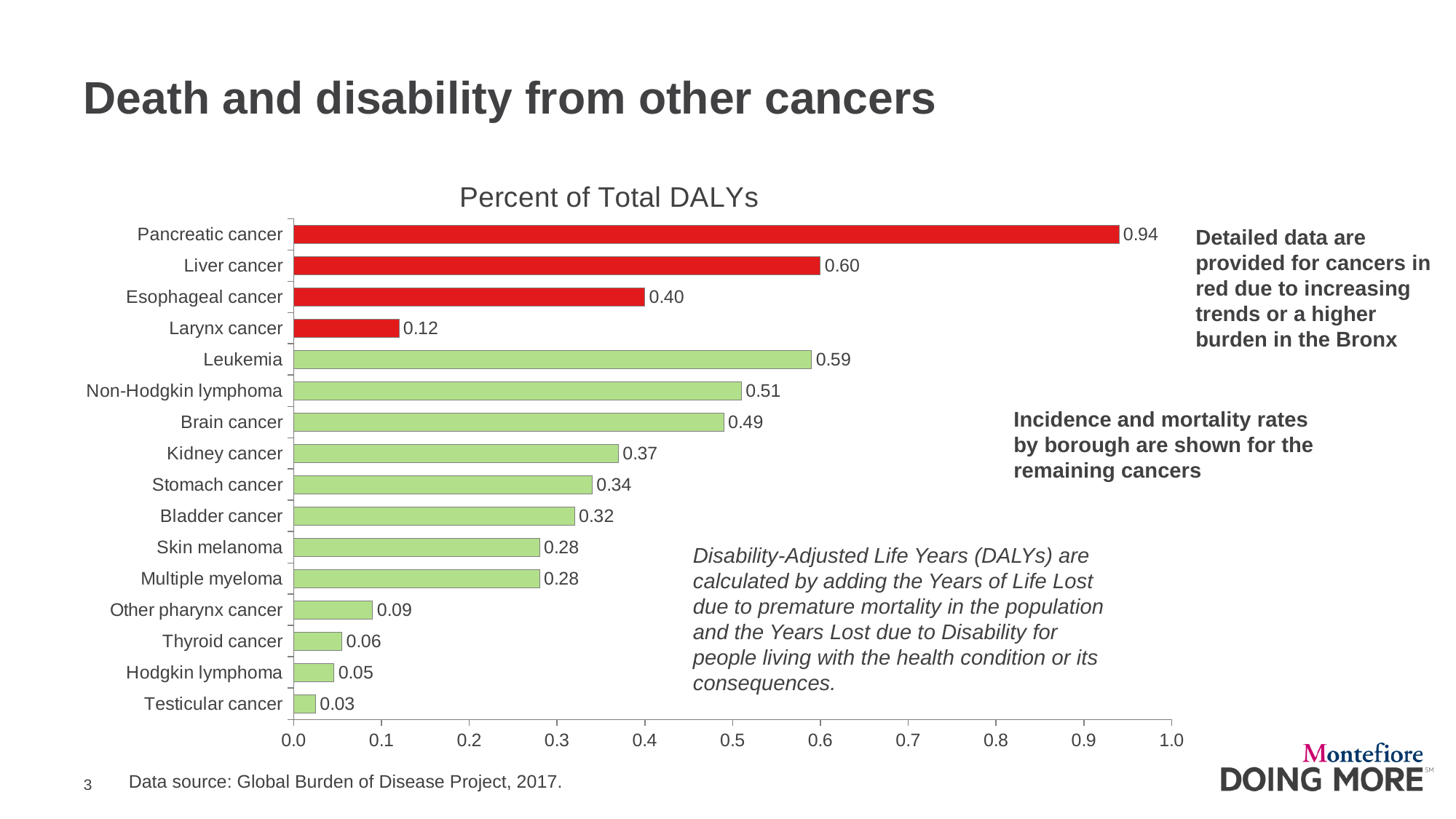
How many bars are coloured red? 4 Which is larger, the value for Esophageal cancer or the value for Brain cancer? Brain cancer How many categories are shown in the chart? 16 What is the difference between the values for Stomach cancer and Bladder cancer? 0.02 Which category has the lowest value? Testicular cancer What kind of chart is shown on the slide? Bar chart What is the difference between the values for Pancreatic cancer and Liver cancer? 0.34 Which category has the highest value? Pancreatic cancer What is the title of the chart? Percent of Total DALYs What is the value for Pancreatic cancer? 0.94 What is the value for Kidney cancer? 0.37 What is the value for Leukemia? 0.59